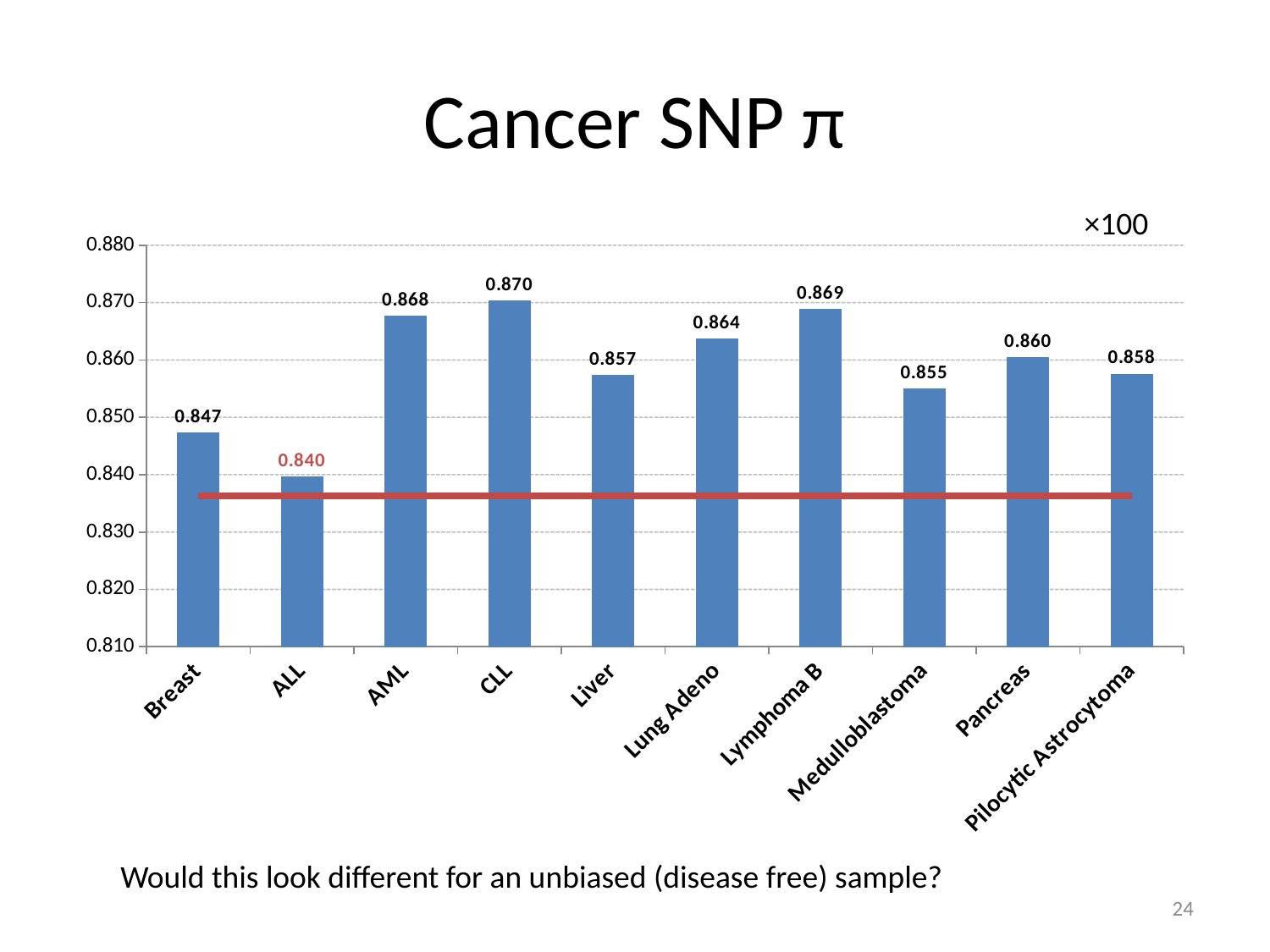
What kind of chart is this? bar chart What is the value for Medulloblastoma? 0.855 What is the title of the chart? Cancer SNP π What is the difference between the values for CLL and ALL? 0.030 What is the value for ALL? 0.840 Which category has the lowest value? ALL Which category has the highest value? CLL Which category's data label is shown in red? ALL What is the value for CLL? 0.870 How many categories are shown on the x axis? 10 Which is larger, the value for Breast or the value for Pancreas? Pancreas Is the value for Lung Adeno greater or less than 0.860? greater